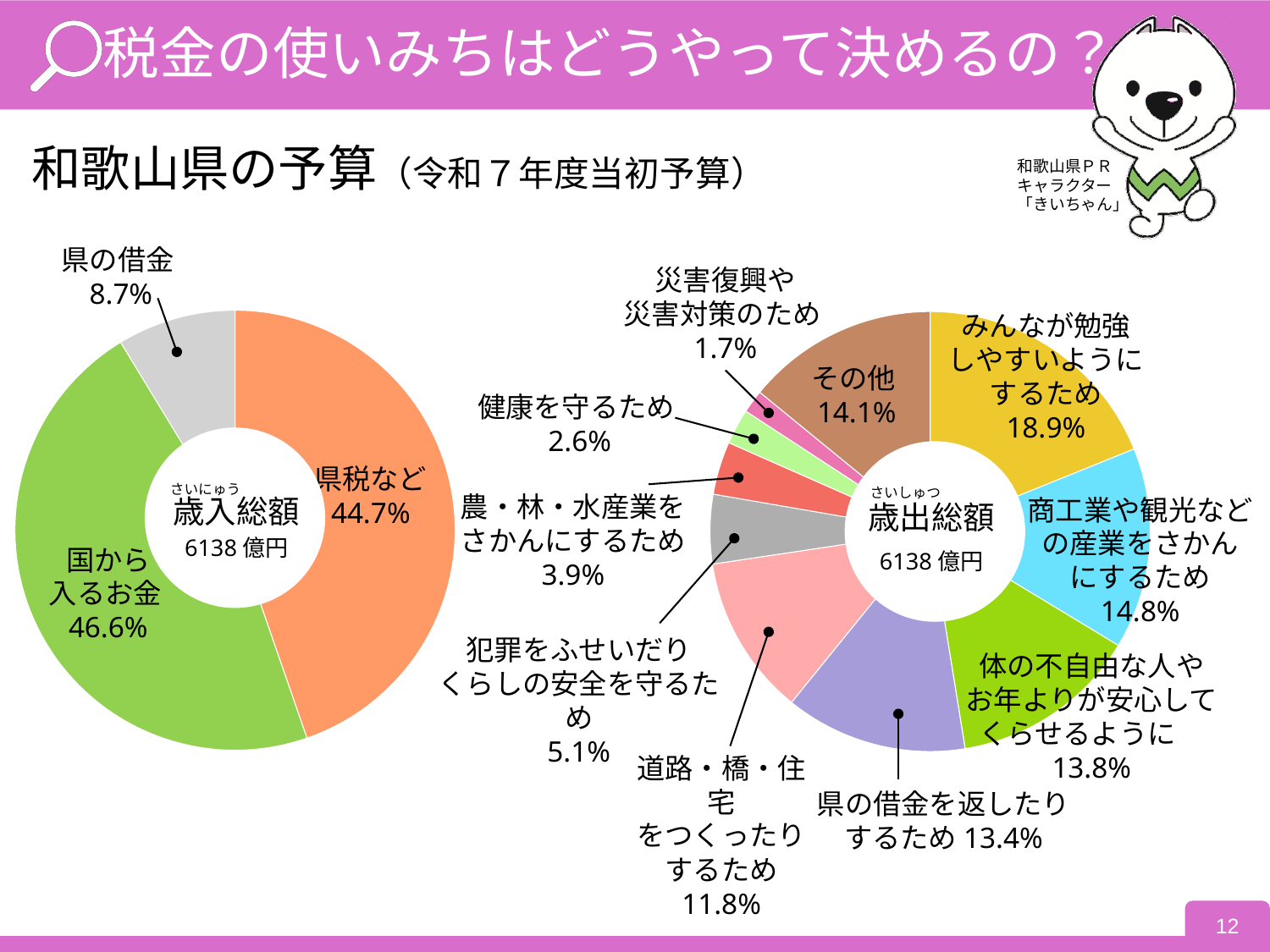
このスライドの2つのグラフはどのような種類のグラフですか？ 円グラフ（ドーナツグラフ） 歳出総額のグラフで、最も割合が小さい項目はどれですか？ 災害復興や災害対策のため 歳出総額のグラフには、いくつの項目がありますか？ 10 歳出総額のグラフで、「商工業や観光などの産業をさかんにするため」と「県の借金を返したりするため」では、どちらの割合が大きいですか？ 商工業や観光などの産業をさかんにするため 歳入総額のグラフで、最も割合が大きい項目はどれですか？ 国から入るお金 歳入総額のグラフで、「国から入るお金」と「県税など」の割合の差はいくらですか？ 1.9% 歳入総額のグラフには、いくつの項目がありますか？ 3 歳入総額のグラフで、「県税など」の割合はいくらですか？ 44.7% 歳出総額のグラフで、最も割合が大きい項目はどれですか？ みんなが勉強しやすいようにするため 歳出総額のグラフで、「健康を守るため」と「農・林・水産業をさかんにするため」の割合の差はいくらですか？ 1.3% 歳入総額のグラフで、最も割合が小さい項目はどれですか？ 県の借金 歳出総額のグラフで、「道路・橋・住宅をつくったりするため」の割合はいくらですか？ 11.8%